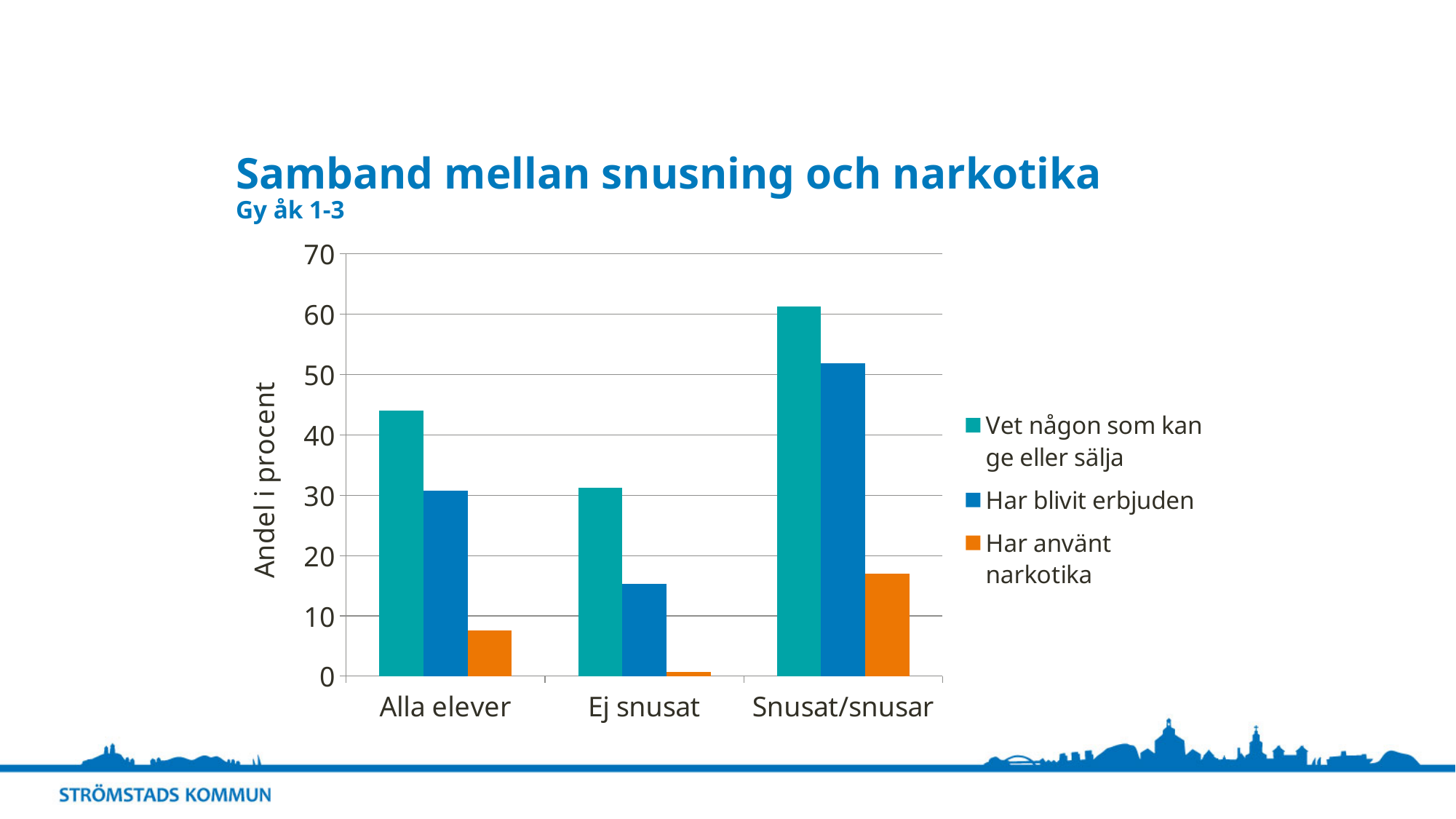
Which is larger: 'Har blivit erbjuden' for 'Alla elever' or 'Har blivit erbjuden' for 'Snusat/snusar'? Snusat/snusar What kind of chart is shown on the slide? bar chart Is the value for 'Vet någon som kan ge eller sälja' in the 'Alla elever' category greater or less than 40? greater Is the value for 'Har blivit erbjuden' in the 'Snusat/snusar' category greater or less than 50? greater Is the value for 'Har använt narkotika' in the 'Snusat/snusar' category greater or less than 10? greater What is the label of the y axis? Andel i procent How many series does the legend list? 3 Which category has the lowest value for 'Har använt narkotika'? Ej snusat Which category has the lowest value for 'Har blivit erbjuden'? Ej snusat How many categories are shown on the x axis? 3 Which category has the highest value for 'Vet någon som kan ge eller sälja'? Snusat/snusar